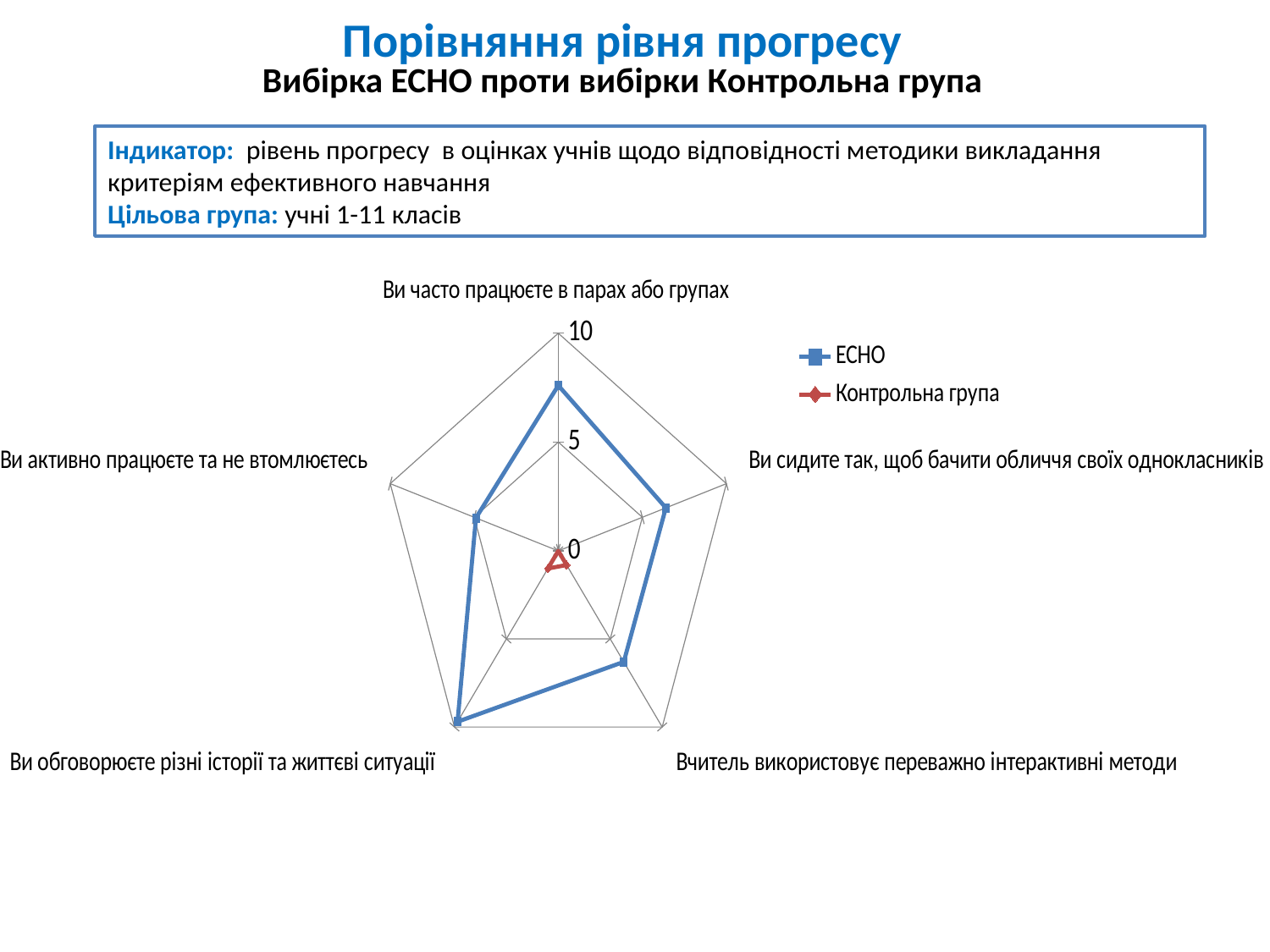
Is the ECHO value for "Вчитель використовує переважно інтерактивні методи" greater or less than 5? greater How many categories (axes) does the radar chart have? 5 Which two series are listed in the chart legend? ECHO and Контрольна група How many series does the chart legend list? 2 Is the Контрольна група value for "Ви часто працюєте в парах або групах" greater or less than 5? less What kind of chart is shown on the slide? Radar chart Is the ECHO value for "Ви часто працюєте в парах або групах" greater or less than 5? greater For "Ви обговорюєте різні історії та життєві ситуації", which series has the larger value, ECHO or Контрольна група? ECHO What is the maximum value shown on the chart's axis scale? 10 For which category does the ECHO series reach its highest value? Ви обговорюєте різні історії та життєві ситуації For which category does the ECHO series have its lowest value? Ви активно працюєте та не втомлюєтесь